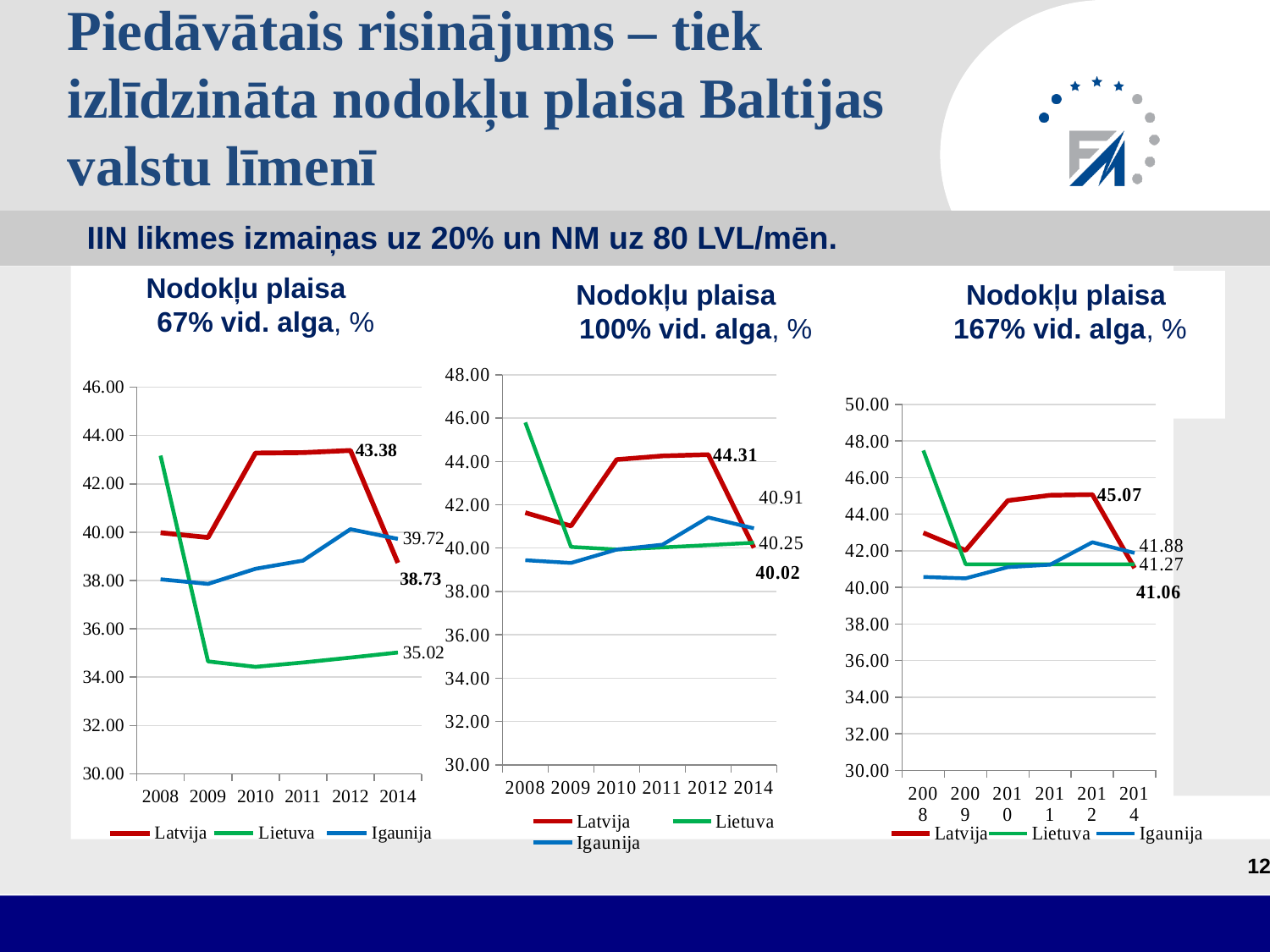
In the chart titled 'Nodokļu plaisa 67% vid. alga, %', which series has the lowest value in 2014? Lietuva How many years are shown on the x axis of the chart titled 'Nodokļu plaisa 67% vid. alga, %'? 6 In the chart titled 'Nodokļu plaisa 67% vid. alga, %', is the value for Lietuva in 2009 greater or less than 36.00? less In the chart titled 'Nodokļu plaisa 67% vid. alga, %', what is the labelled value for Latvija in 2012? 43.38 In the chart titled 'Nodokļu plaisa 67% vid. alga, %', by how much does the Latvija value fall from 2012 (43.38) to 2014 (38.73)? 4.65 In the chart titled 'Nodokļu plaisa 167% vid. alga, %', which series has the highest labelled value in 2014: Latvija, Lietuva or Igaunija? Igaunija In the chart titled 'Nodokļu plaisa 100% vid. alga, %', is the 2014 value for Latvija (40.02) or Lietuva (40.25) larger? Lietuva In the chart titled 'Nodokļu plaisa 100% vid. alga, %', what is the labelled value for Igaunija in 2014? 40.91 In the chart titled 'Nodokļu plaisa 167% vid. alga, %', what is the labelled value for Latvija in 2012? 45.07 What kind of chart is the chart titled 'Nodokļu plaisa 167% vid. alga, %'? Line chart How many series does the legend list in the chart titled 'Nodokļu plaisa 100% vid. alga, %'? 3 In the chart titled 'Nodokļu plaisa 67% vid. alga, %', what is the labelled value for Lietuva in 2014? 35.02